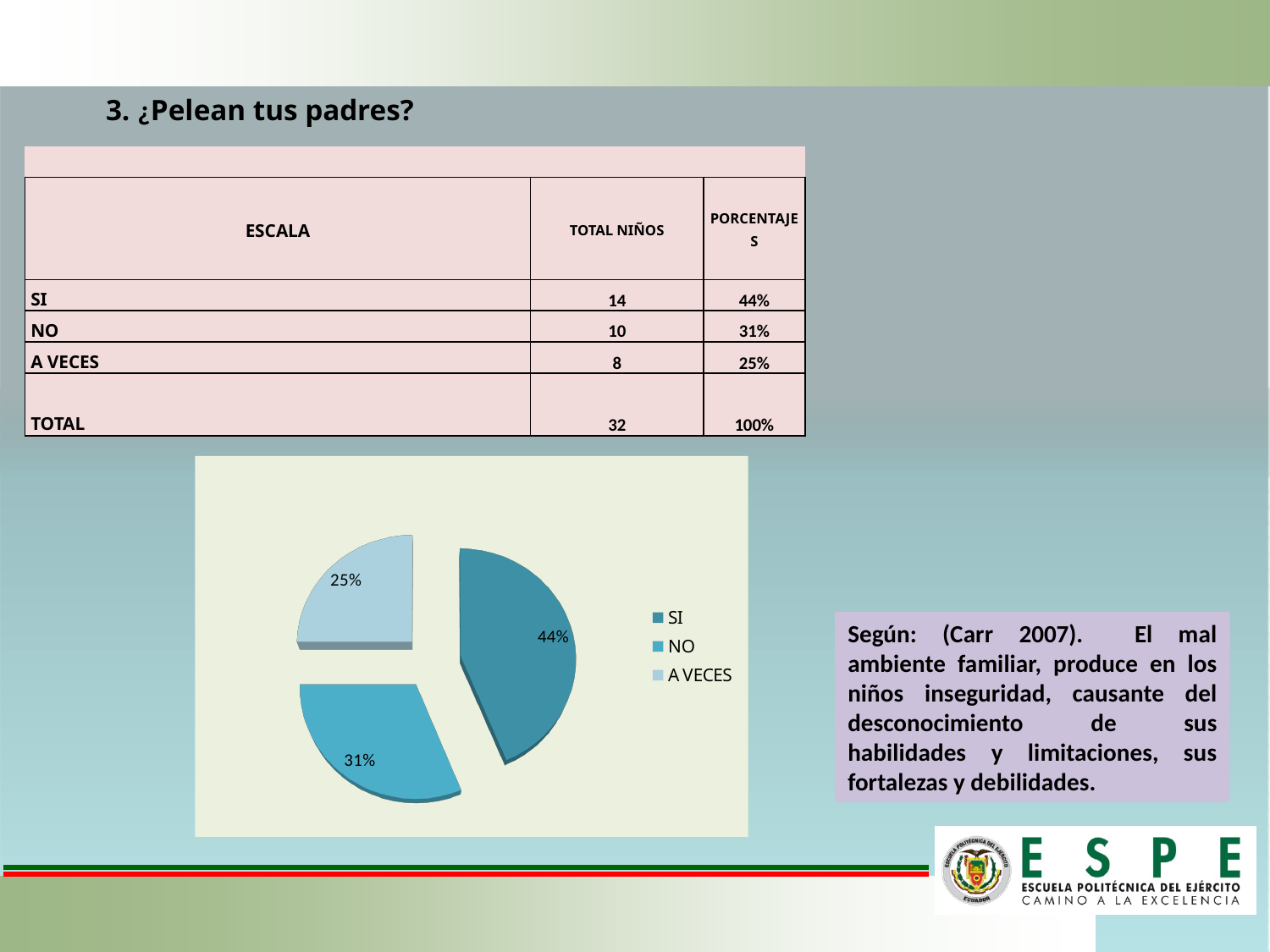
What percentage does the SI slice of the pie chart show? 44% How many slices does the pie chart have? 3 Which category has the smallest slice in the pie chart? A VECES What percentage does the NO slice of the pie chart show? 31% Which legend entry is shown with the lightest blue colour in the pie chart? A VECES What is the difference in percentage points between the SI slice and the NO slice? 13 What percentage does the A VECES slice of the pie chart show? 25% Which slice is larger, NO or A VECES? NO Which category has the largest slice in the pie chart? SI What is the difference in percentage points between the NO slice and the A VECES slice? 6 What kind of chart is shown on the slide? pie chart How many entries does the legend of the pie chart list? 3